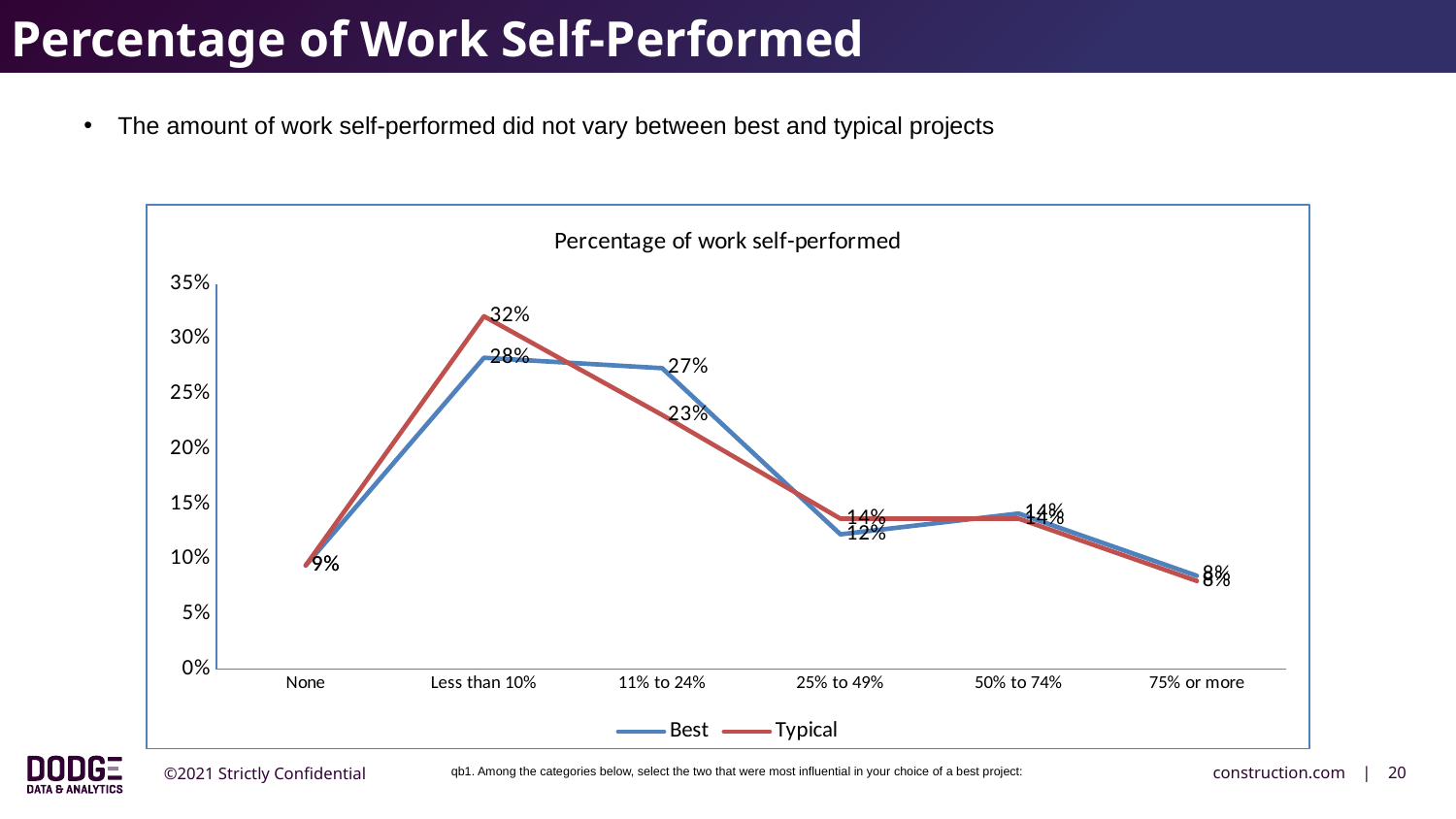
What is the value for Typical in the 'Less than 10%' category? 32% What kind of chart is shown on the slide? line chart How many series does the legend list? 2 What is the value for Typical in the '11% to 24%' category? 23% Which category has the lowest value for the Best series? 75% or more What is the difference between Typical and Best in the 'Less than 10%' category? 4% In the '11% to 24%' category, which series has the larger value, Best or Typical? Best What is the value for Best in the 'Less than 10%' category? 28% Which category has the highest value for the Typical series? Less than 10% How many categories are shown on the x axis? 6 What is the value for Best in the '25% to 49%' category? 12% What is the value for Best in the '11% to 24%' category? 27%